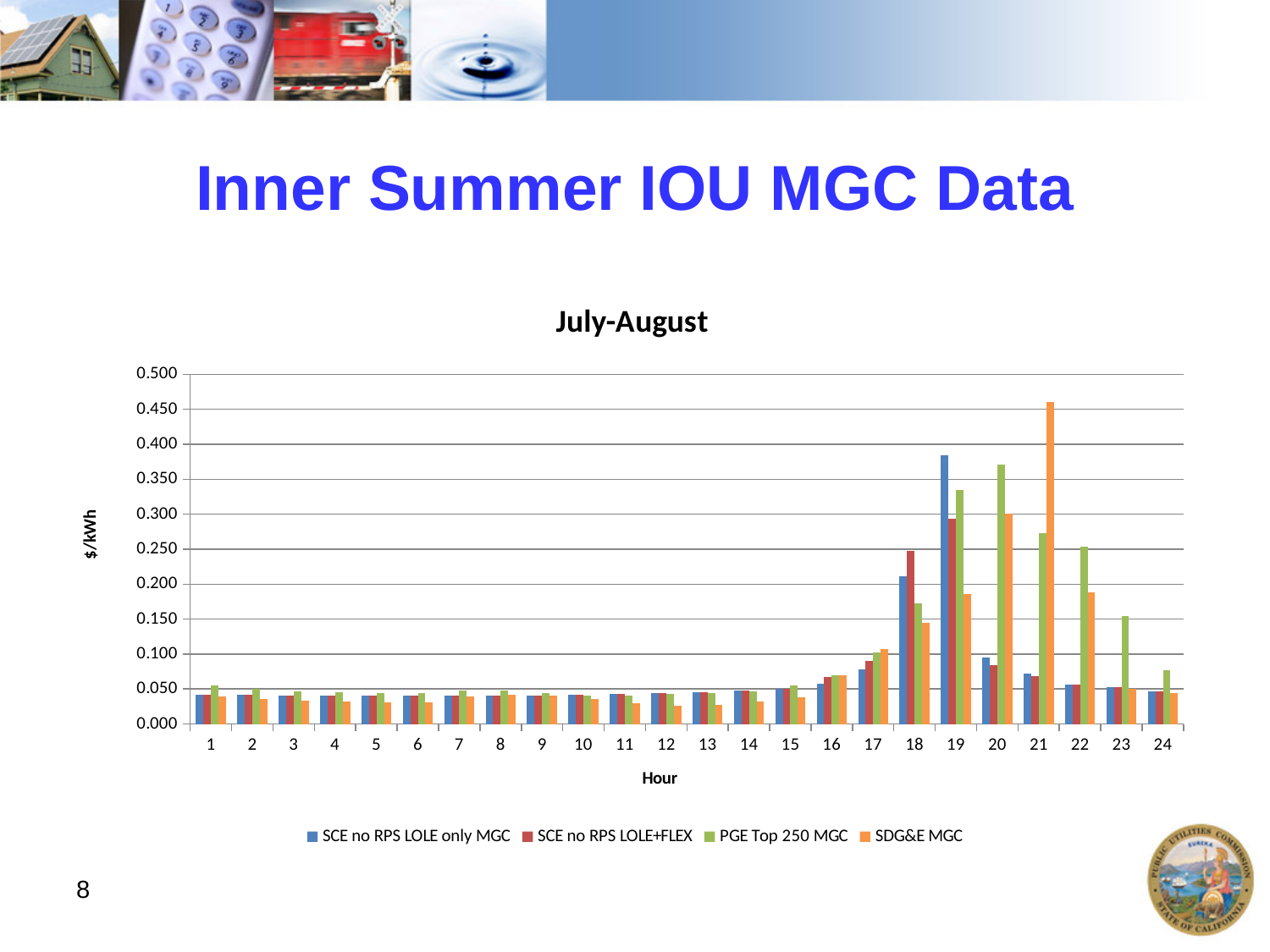
How many series does the legend list? 4 How many hours are shown along the x axis? 24 At which hour is the SCE no RPS LOLE only MGC value highest? 19 Is the SDG&E MGC value at hour 21 greater or less than 0.400? greater At hour 19, which is larger: SCE no RPS LOLE only MGC or PGE Top 250 MGC? SCE no RPS LOLE only MGC What kind of chart is shown on the slide? bar chart At which hour is the PGE Top 250 MGC value highest? 20 Is the PGE Top 250 MGC value at hour 23 greater or less than 0.100? greater Is the SCE no RPS LOLE only MGC value at hour 19 greater or less than 0.350? greater At which hour is the SDG&E MGC value highest? 21 What is the label on the vertical axis of the chart? $/kWh At hour 18, which is larger: SCE no RPS LOLE+FLEX or SDG&E MGC? SCE no RPS LOLE+FLEX